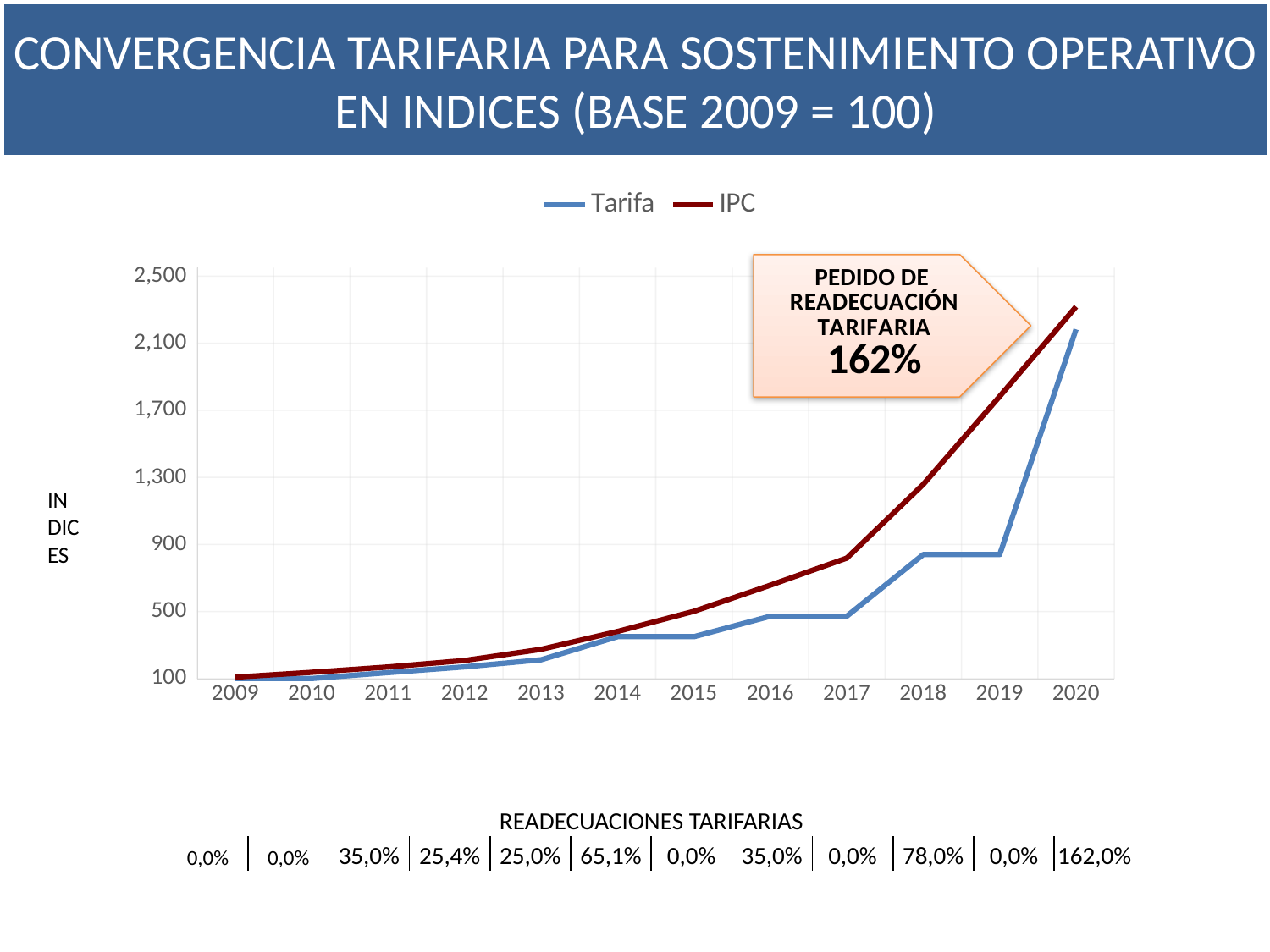
Does the IPC line rise or fall from 2009 to 2020? rise Is the IPC value for 2019 greater or less than 1,300? greater Is the IPC value for 2020 greater or less than 2,100? greater In the 'READECUACIONES TARIFARIAS' row below the chart, what value is shown for 2018? 78,0% What are the two series named in the legend? Tarifa and IPC Is the Tarifa value for 2017 greater or less than 500? less How many series does the chart legend list? 2 In 2019, which series has the larger value, Tarifa or IPC? IPC What percentage is shown in the callout box labelled 'PEDIDO DE READECUACIÓN TARIFARIA'? 162% What kind of chart is shown on the slide? line chart In which year does the Tarifa series reach its highest value? 2020 How many years are shown along the x axis of the chart? 12